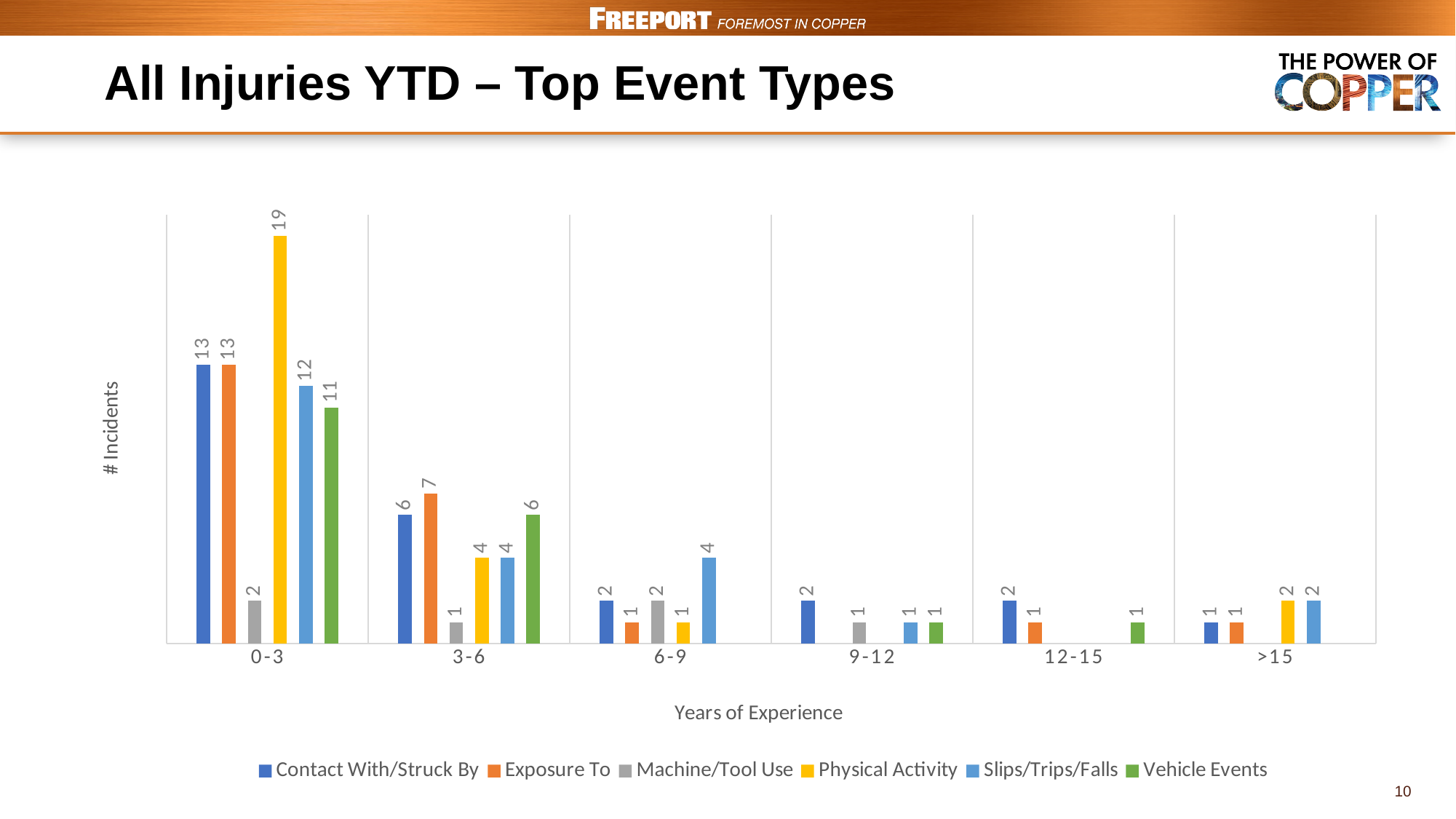
What kind of chart is shown on the slide? Bar chart What is the value for Exposure To in the 3-6 years of experience group? 7 What is the difference between Physical Activity and Slips/Trips/Falls in the 0-3 years of experience group? 7 What is the value for Physical Activity in the 0-3 years of experience group? 19 Which event type has the lowest number of incidents in the 0-3 years of experience group? Machine/Tool Use How many series does the legend list? 6 What is the value for Slips/Trips/Falls in the 6-9 years of experience group? 4 What is the value for Vehicle Events in the 0-3 years of experience group? 11 Which is larger in the 3-6 years of experience group: Exposure To or Contact With/Struck By? Exposure To Which event type has the highest number of incidents in the 0-3 years of experience group? Physical Activity How many years-of-experience categories are shown on the x axis? 6 What is the label of the x axis? Years of Experience